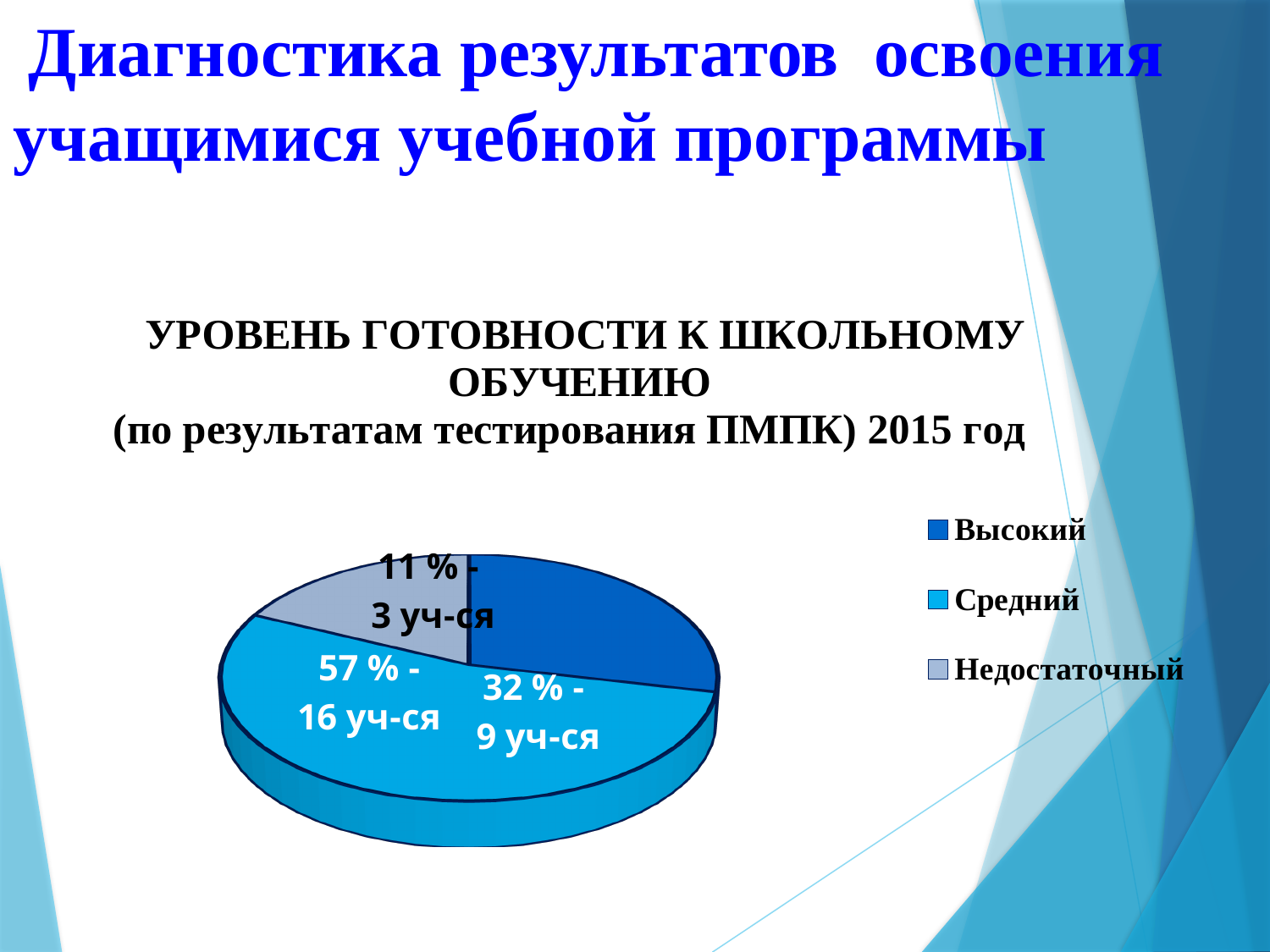
What is the difference in percentage points between the Средний and Высокий slices? 25 How many entries does the legend of the pie chart list? 3 Which category has the smallest slice of the pie? Недостаточный What percentage share does the Недостаточный slice have? 11 % Which category has the largest slice of the pie? Средний How many students (уч-ся) are in the Высокий category? 9 уч-ся What percentage share does the Высокий slice have? 32 % What percentage share does the Средний slice have? 57 % How many students (уч-ся) are in the Средний category? 16 уч-ся What kind of chart is shown on the slide? pie chart What is the total number of students across all three categories of the pie chart? 28 How many slices does the pie chart have? 3